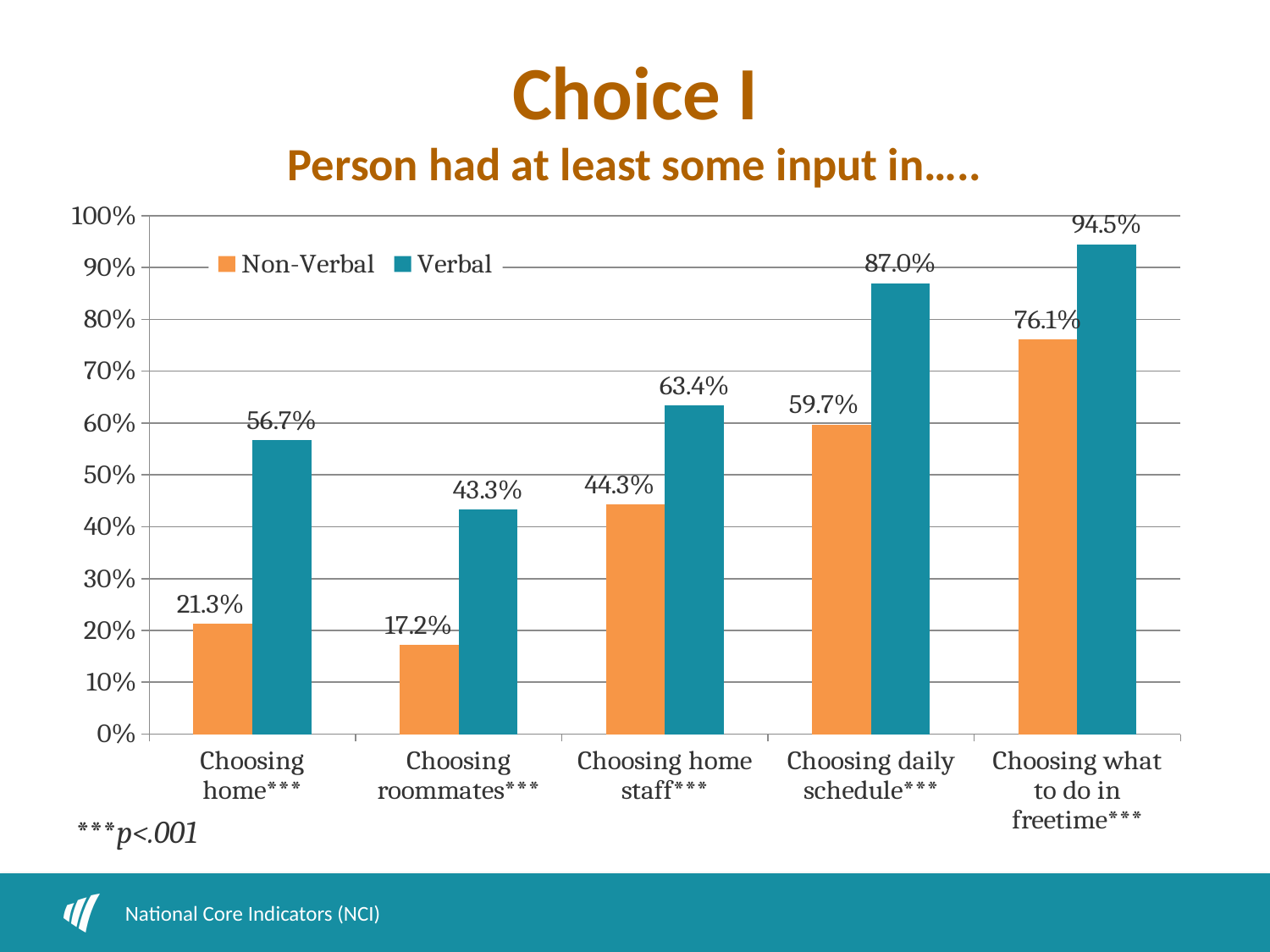
Which category has the lowest Non-Verbal value? Choosing roommates*** What is the difference between the Verbal and Non-Verbal values for Choosing home staff***? 19.1% Which is larger: the Non-Verbal value for Choosing daily schedule*** or the Verbal value for Choosing home***? Non-Verbal value for Choosing daily schedule*** What colour are the Verbal bars? Teal What is the Verbal value for Choosing roommates***? 43.3% How many categories are shown on the x axis? 5 Which category has the highest Verbal value? Choosing what to do in freetime*** Do the Verbal values rise or fall from Choosing home staff*** to Choosing what to do in freetime***? Rise How many series does the legend list? 2 What kind of chart is shown on the slide? Bar chart What is the Non-Verbal value for Choosing home***? 21.3% What is the Verbal value for Choosing daily schedule***? 87.0%